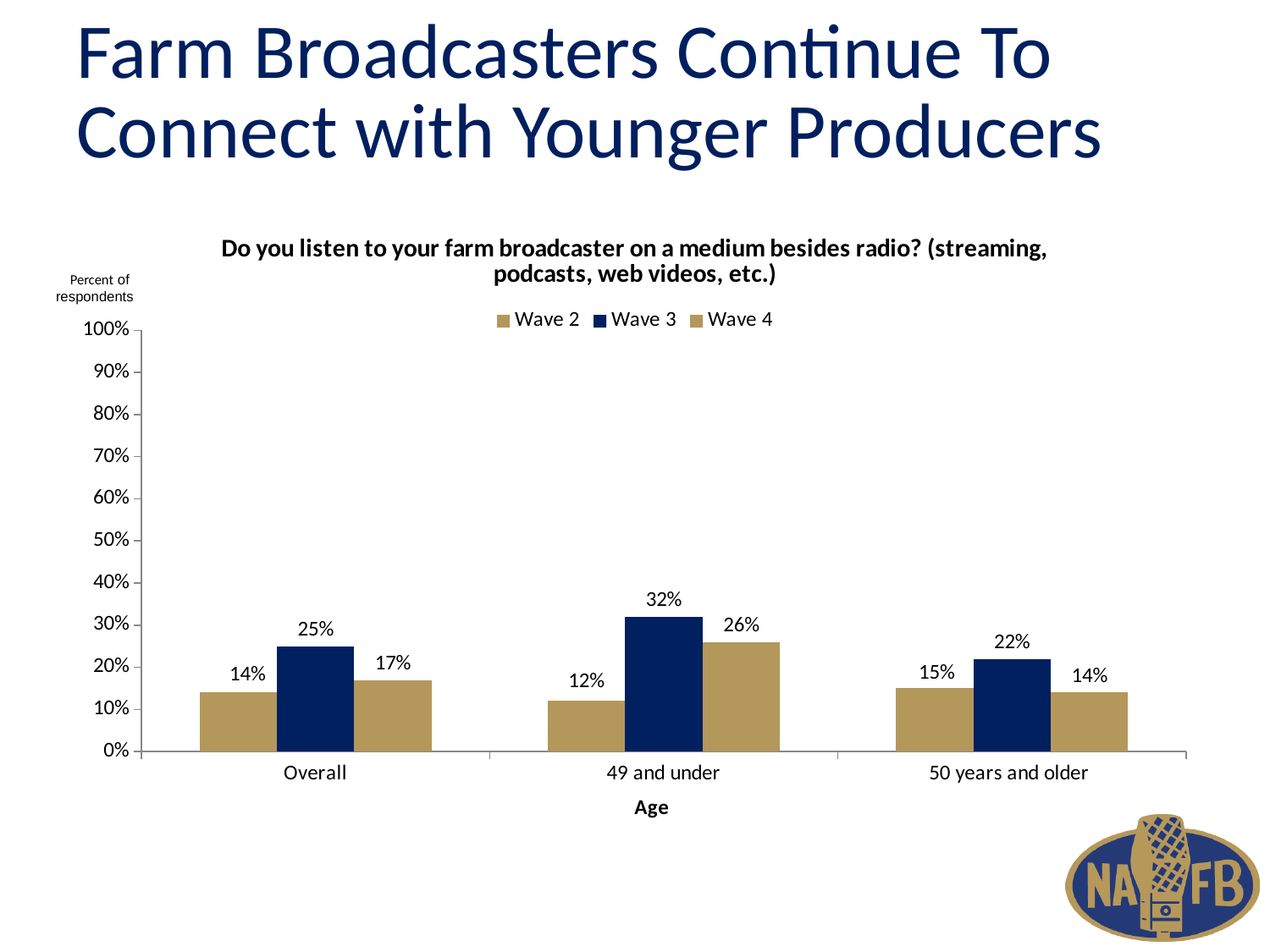
What is the Wave 2 value for the Overall category? 14% Which is larger for the 50 years and older group, the Wave 2 value or the Wave 4 value? Wave 2 How many age categories are shown on the x axis? 3 What kind of chart is shown on the slide? bar chart What is the label of the x axis? Age What is the Wave 4 value for the 50 years and older group? 14% Which age category has the lowest Wave 2 value? 49 and under Which age category has the highest Wave 3 value? 49 and under Is the Wave 3 value for the Overall category greater or less than 20%? greater What is the difference between the Wave 3 and Wave 2 values for the 49 and under group? 20% How many series does the legend list? 3 What is the Wave 3 value for the 49 and under group? 32%